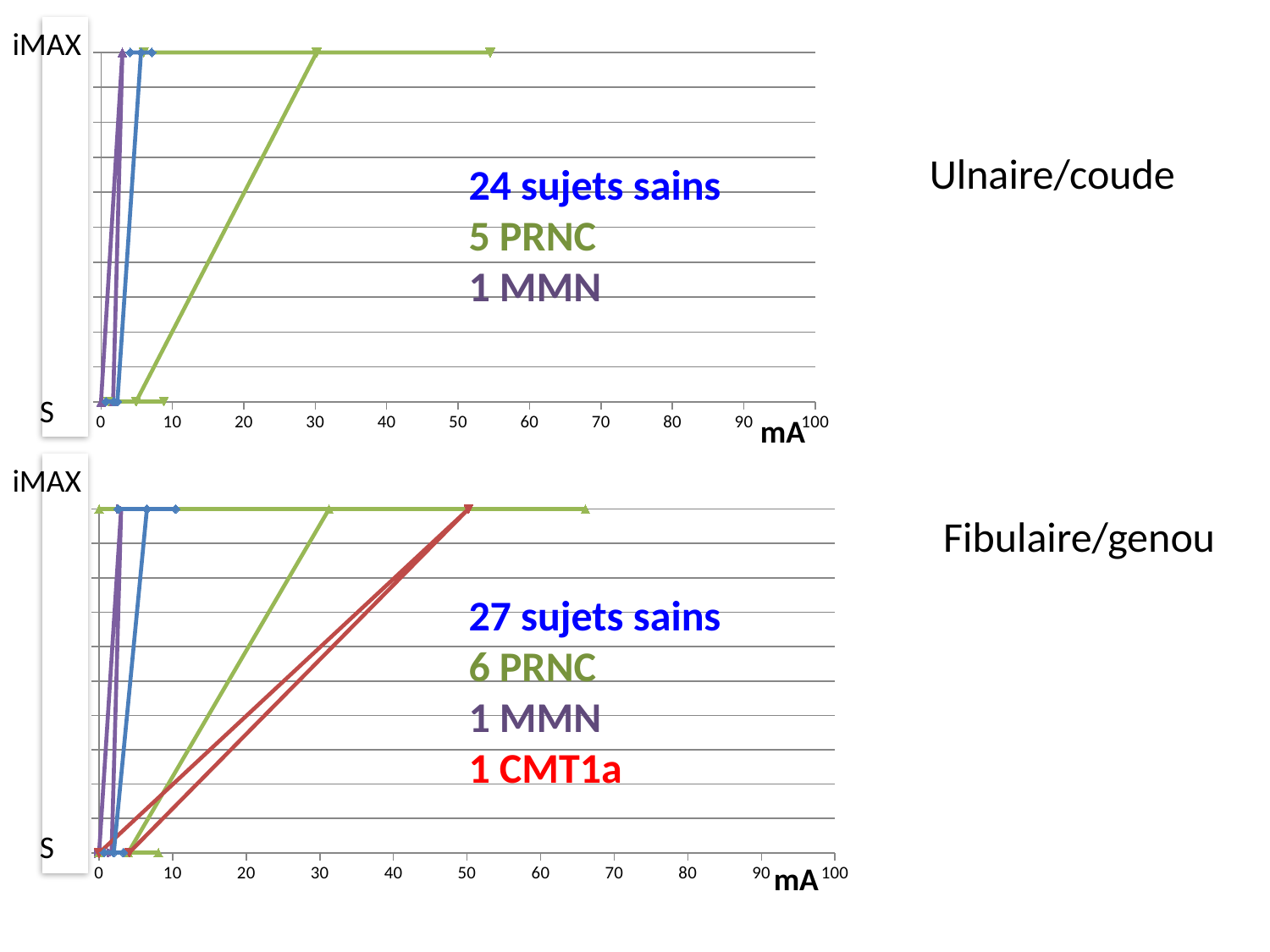
How many subject groups are listed on the Fibulaire/genou chart? 4 In the Ulnaire/coude chart, how many PRNC subjects are indicated? 5 In the Ulnaire/coude chart, is the current at which the furthest PRNC line reaches iMAX greater or less than 50 mA? greater What kind of chart is the Ulnaire/coude chart? line chart Which subject group appears only on the Fibulaire/genou chart and not on the Ulnaire/coude chart? CMT1a In the Fibulaire/genou chart, which group's line reaches iMAX at the highest current: PRNC or CMT1a? PRNC In the Fibulaire/genou chart, is the current at which the furthest PRNC line reaches iMAX greater or less than 60 mA? greater What unit is shown on the x axis of both charts? mA In the Ulnaire/coude chart, how many 'sujets sains' are indicated? 24 How many subject groups are listed on the Ulnaire/coude chart? 3 In the Fibulaire/genou chart, how many PRNC subjects are indicated? 6 In the Fibulaire/genou chart, how many 'sujets sains' are indicated? 27